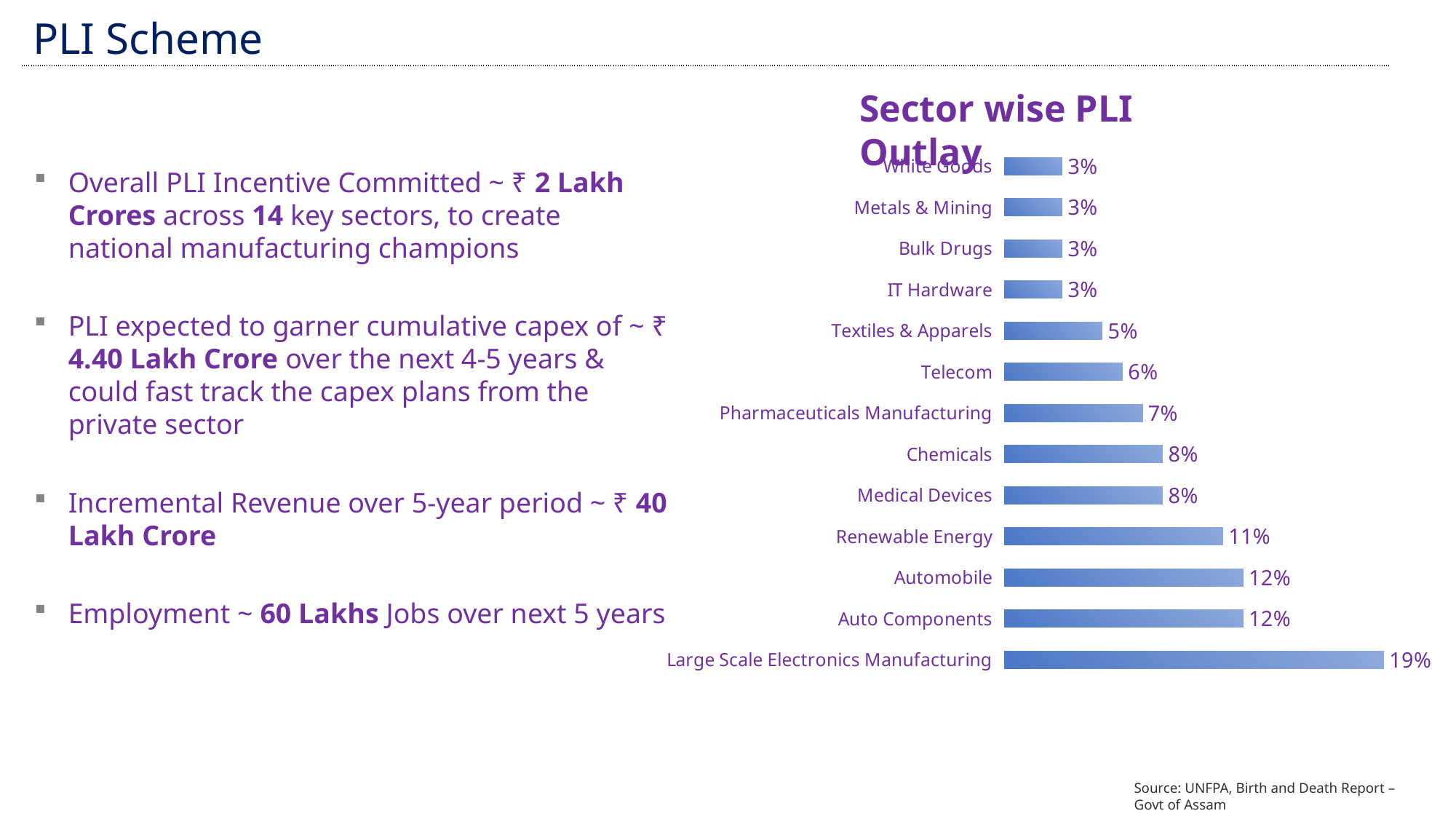
What is the difference between the values for Renewable Energy and Textiles & Apparels? 6% Which sector has the highest PLI outlay share in the chart? Large Scale Electronics Manufacturing What is the difference between the values for Large Scale Electronics Manufacturing and Automobile? 7% Which is larger, the value for Auto Components or the value for Telecom? Auto Components What is the value for Renewable Energy in the Sector wise PLI Outlay chart? 11% What kind of chart is the Sector wise PLI Outlay chart? Bar chart What is the value for Pharmaceuticals Manufacturing in the Sector wise PLI Outlay chart? 7% What is the value for Large Scale Electronics Manufacturing in the Sector wise PLI Outlay chart? 19% Which is larger, the value for Chemicals or the value for Textiles & Apparels? Chemicals What is the value for Telecom in the Sector wise PLI Outlay chart? 6% What is the title of the chart on the slide? Sector wise PLI Outlay How many sectors are shown in the Sector wise PLI Outlay chart? 13